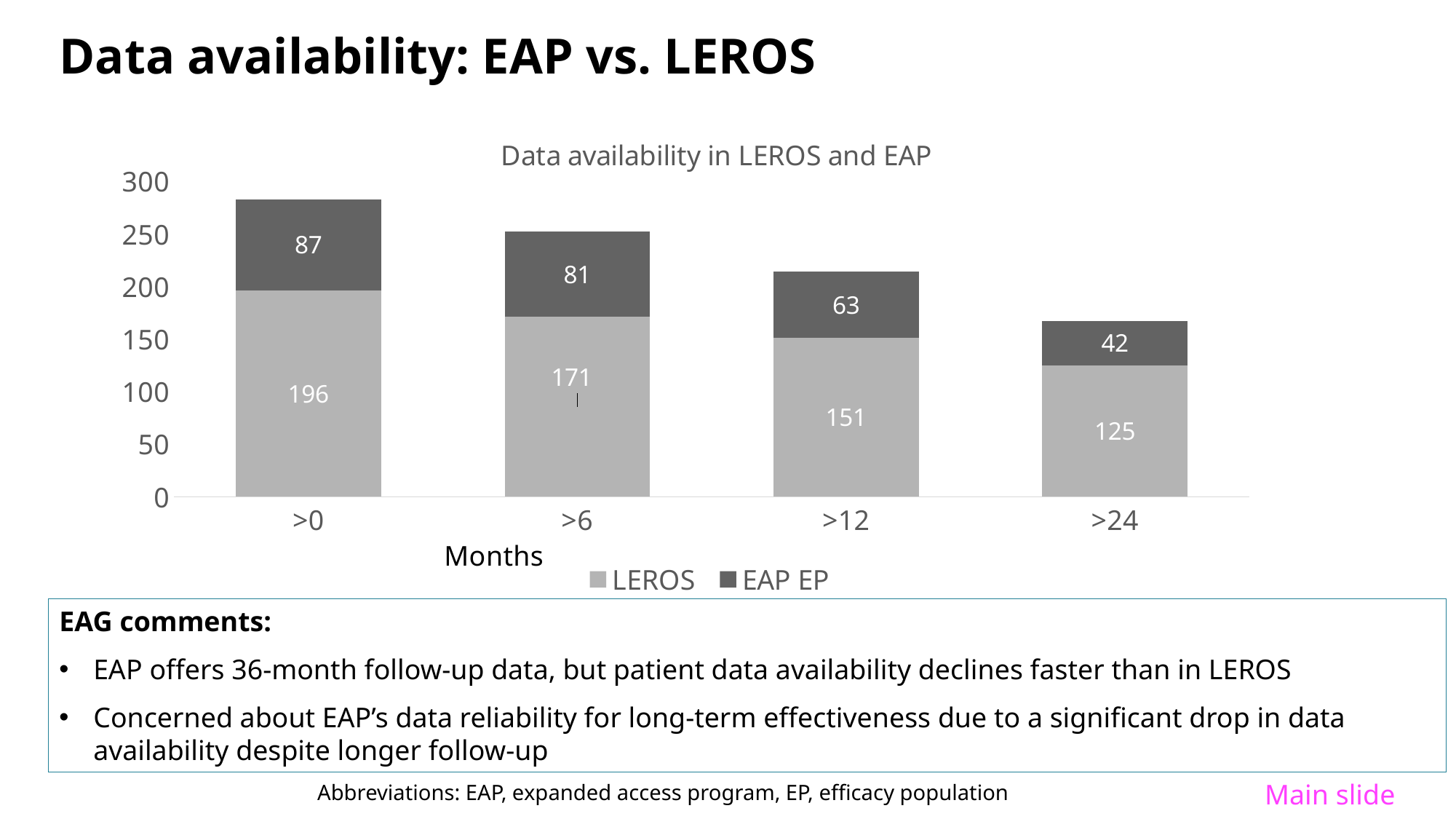
What is the LEROS value at >0 months? 196 How many series does the legend list? 2 Which is larger: the EAP EP value at >6 months or at >12 months? >6 months Which month category has the lowest EAP EP value? >24 What is the EAP EP value at >12 months? 63 What kind of chart is shown? Stacked bar chart What is the difference between the LEROS value at >0 months and at >24 months? 71 Which month category has the highest LEROS value? >0 How many month categories are shown on the x axis? 4 What is the total of the stacked bar at >24 months? 167 What is the EAP EP value at >24 months? 42 What is the total of the stacked bar at >6 months? 252